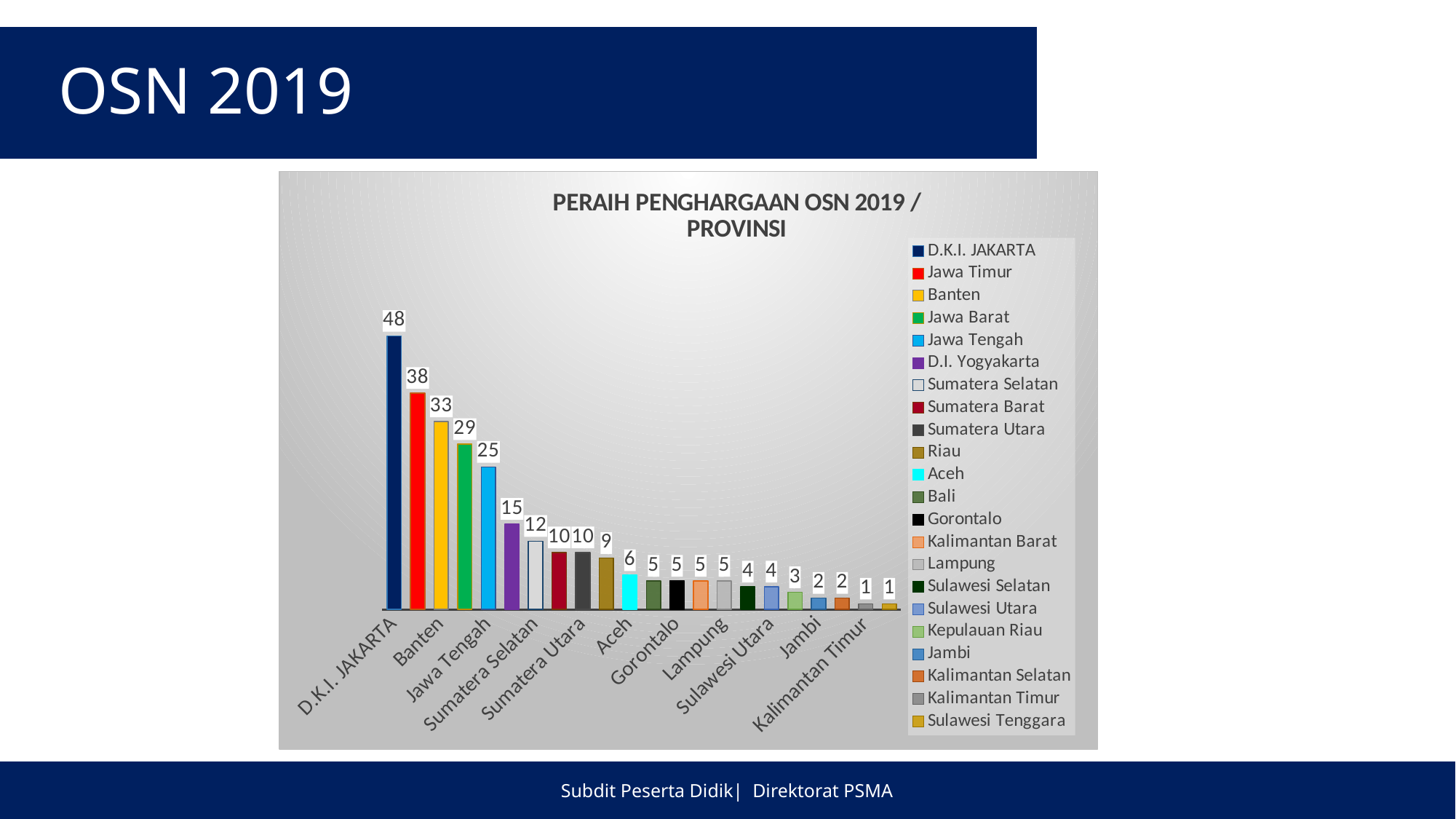
Which has a larger value, Banten or Jawa Tengah? Banten What is the lowest value shown on any bar in the chart? 1 What is the difference between the values for D.K.I. JAKARTA and Jawa Timur? 10 What kind of chart is shown on the slide? Bar chart Do the bar values rise or fall from left to right along the x axis? Fall How many entries does the legend list? 22 What value is shown for Jawa Tengah? 25 Which province has the highest value in the chart? D.K.I. JAKARTA What value is shown for Aceh? 6 How many bars (provinces) are plotted in the chart? 22 What value is shown for Jawa Timur? 38 What value is shown for D.K.I. JAKARTA? 48